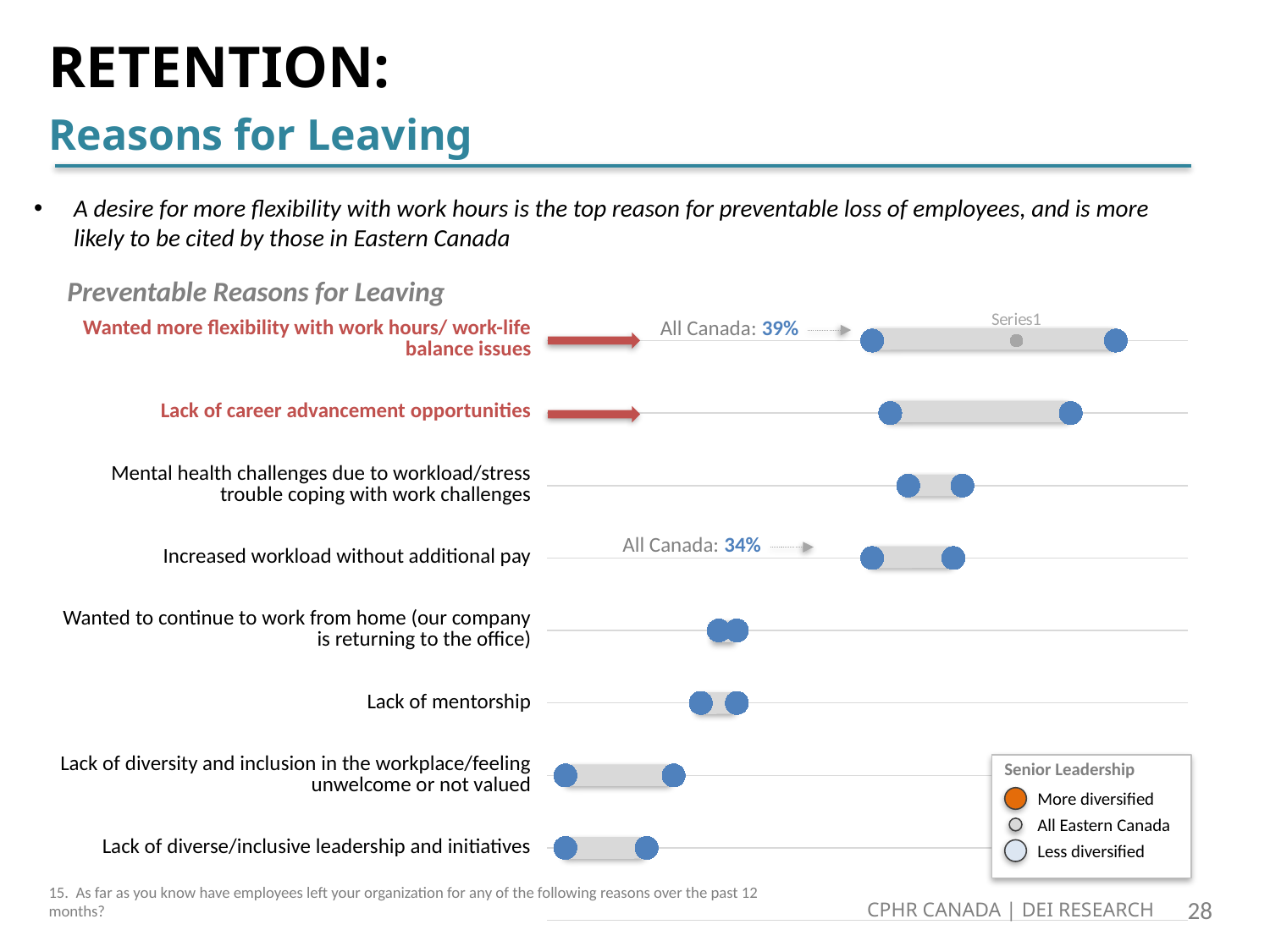
What is the All Canada value for 'Increased workload without additional pay'? 34% What kind of chart is shown on the slide? Dot (dumbbell) range chart What is the title of the chart? Preventable Reasons for Leaving How many reasons for leaving are listed in the chart? 8 Which has a higher All Canada value: 'Wanted more flexibility with work hours/ work-life balance issues' or 'Increased workload without additional pay'? Wanted more flexibility with work hours/ work-life balance issues Which reason has the rightmost (highest) plotted point in the chart? Wanted more flexibility with work hours/ work-life balance issues What is the difference between the All Canada values for 'Wanted more flexibility with work hours/ work-life balance issues' (39%) and 'Increased workload without additional pay' (34%)? 5 percentage points Which reason has the widest spread between its two plotted points? Wanted more flexibility with work hours/ work-life balance issues Which two reasons are highlighted in red with arrows in the chart? Wanted more flexibility with work hours/ work-life balance issues; Lack of career advancement opportunities How many entries does the 'Senior Leadership' legend list? 3 What is the All Canada value for 'Wanted more flexibility with work hours/ work-life balance issues'? 39%